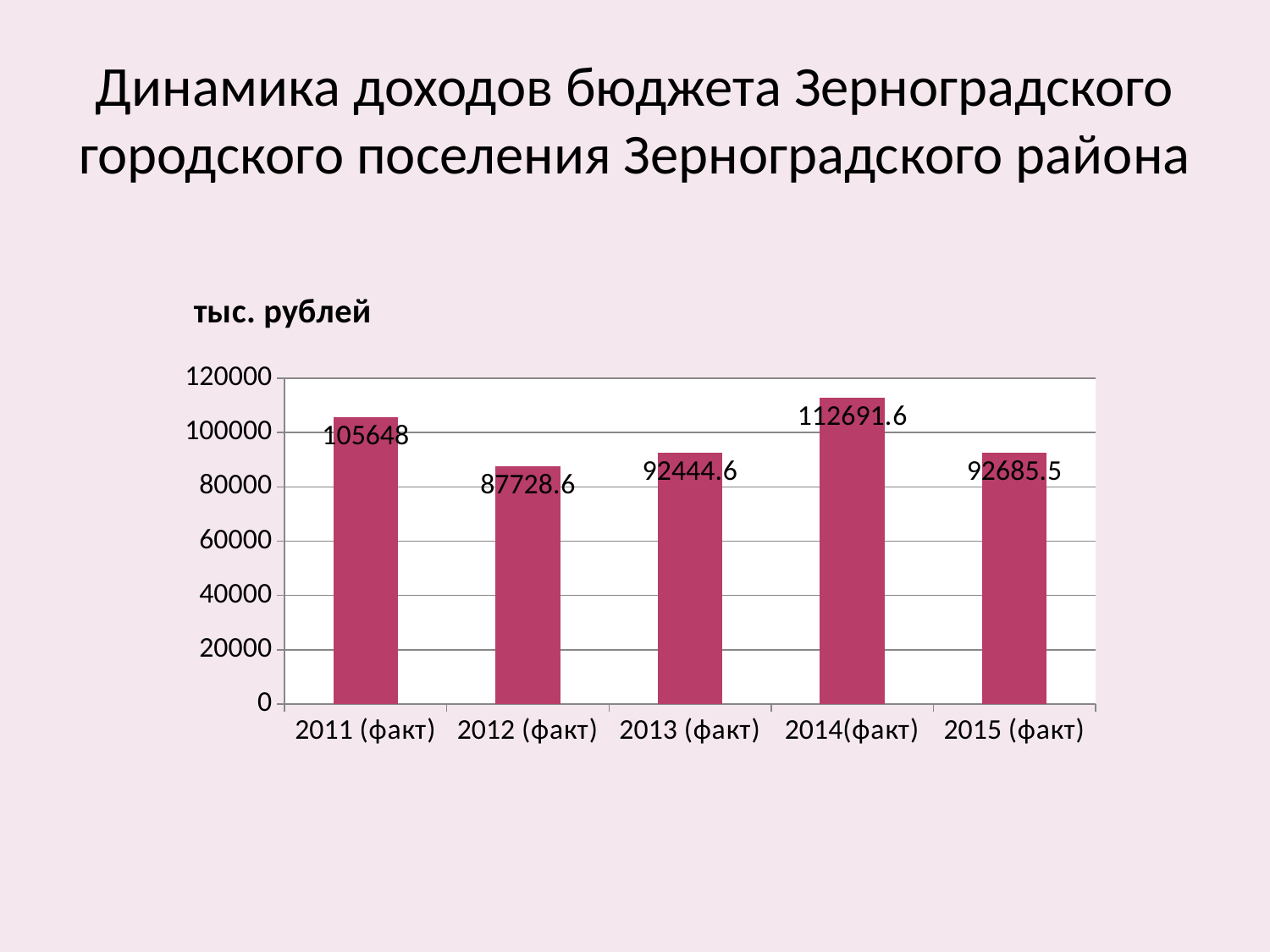
What is the difference between the values for 2011 (факт) and 2012 (факт)? 17919.4 Is the value for 2013 (факт) greater or less than 100000? less What is the budget revenue value for 2011 (факт)? 105648 Which year has the lowest budget revenue? 2012 (факт) What kind of chart is shown on the slide? bar chart What is the value shown for 2014(факт)? 112691.6 Which year has the highest budget revenue? 2014(факт) What is the value shown for 2015 (факт)? 92685.5 What is the value shown for 2012 (факт)? 87728.6 Which is larger, the value for 2011 (факт) or the value for 2013 (факт)? 2011 (факт) What is the difference between the values for 2014(факт) and 2011 (факт)? 7043.6 How many years (categories) are shown on the chart? 5